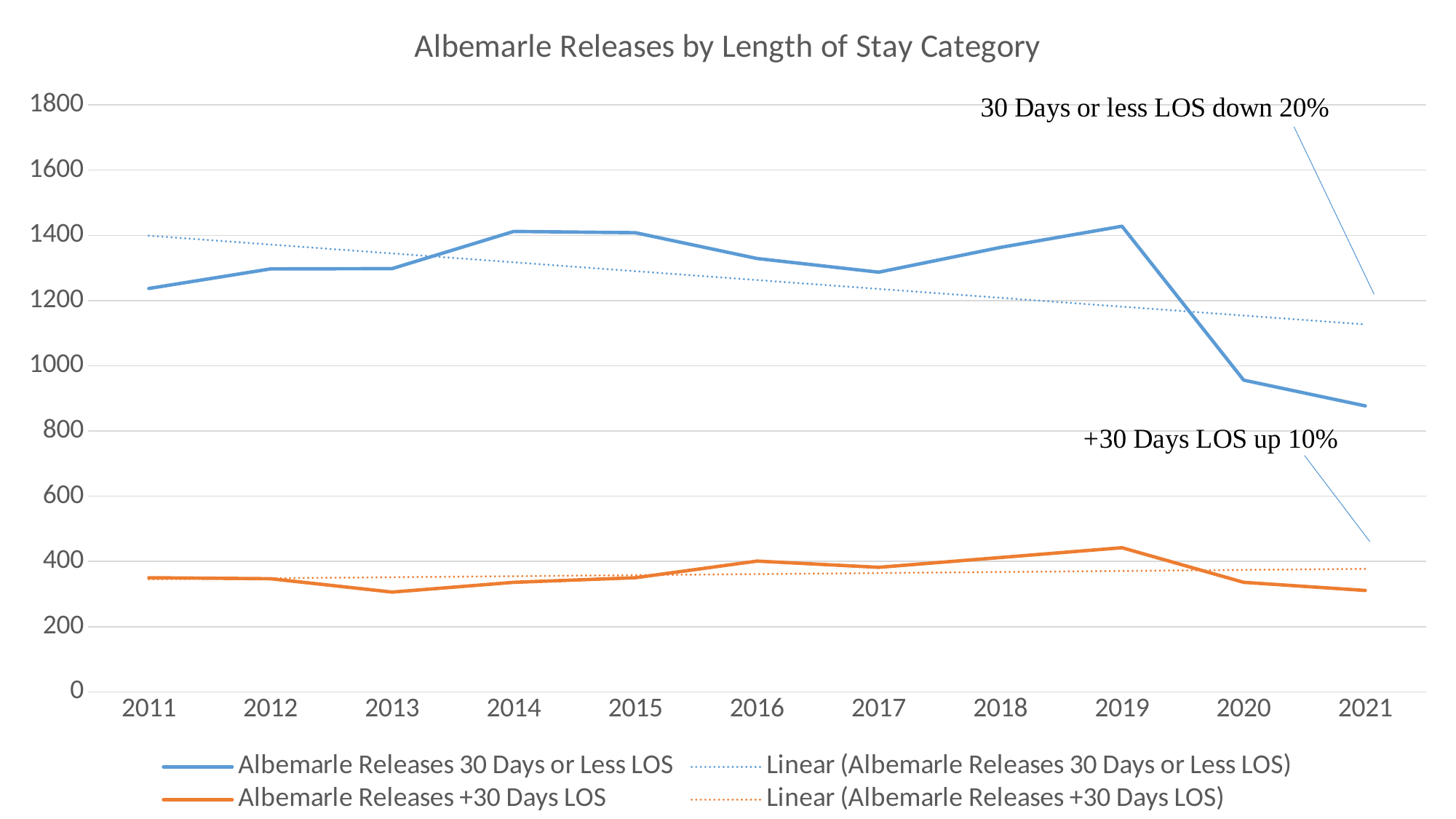
In which year is the value for Albemarle Releases +30 Days LOS highest? 2019 How many entries does the legend list? 4 Is the value for Albemarle Releases 30 Days or Less LOS in 2020 greater or less than 1000? less Does the Albemarle Releases 30 Days or Less LOS line rise or fall from 2019 to 2021? Fall How many years are shown on the x axis? 11 According to the annotation on the chart, by what percentage is 30 Days or less LOS down? 20% What kind of chart is shown on the slide? Line chart In which year is the value for Albemarle Releases 30 Days or Less LOS lowest? 2021 Is the value for Albemarle Releases +30 Days LOS in 2019 greater or less than 400? greater Is the value for Albemarle Releases 30 Days or Less LOS in 2011 greater or less than 1200? greater What is the title of the chart? Albemarle Releases by Length of Stay Category Which year has the larger value for Albemarle Releases 30 Days or Less LOS, 2019 or 2020? 2019